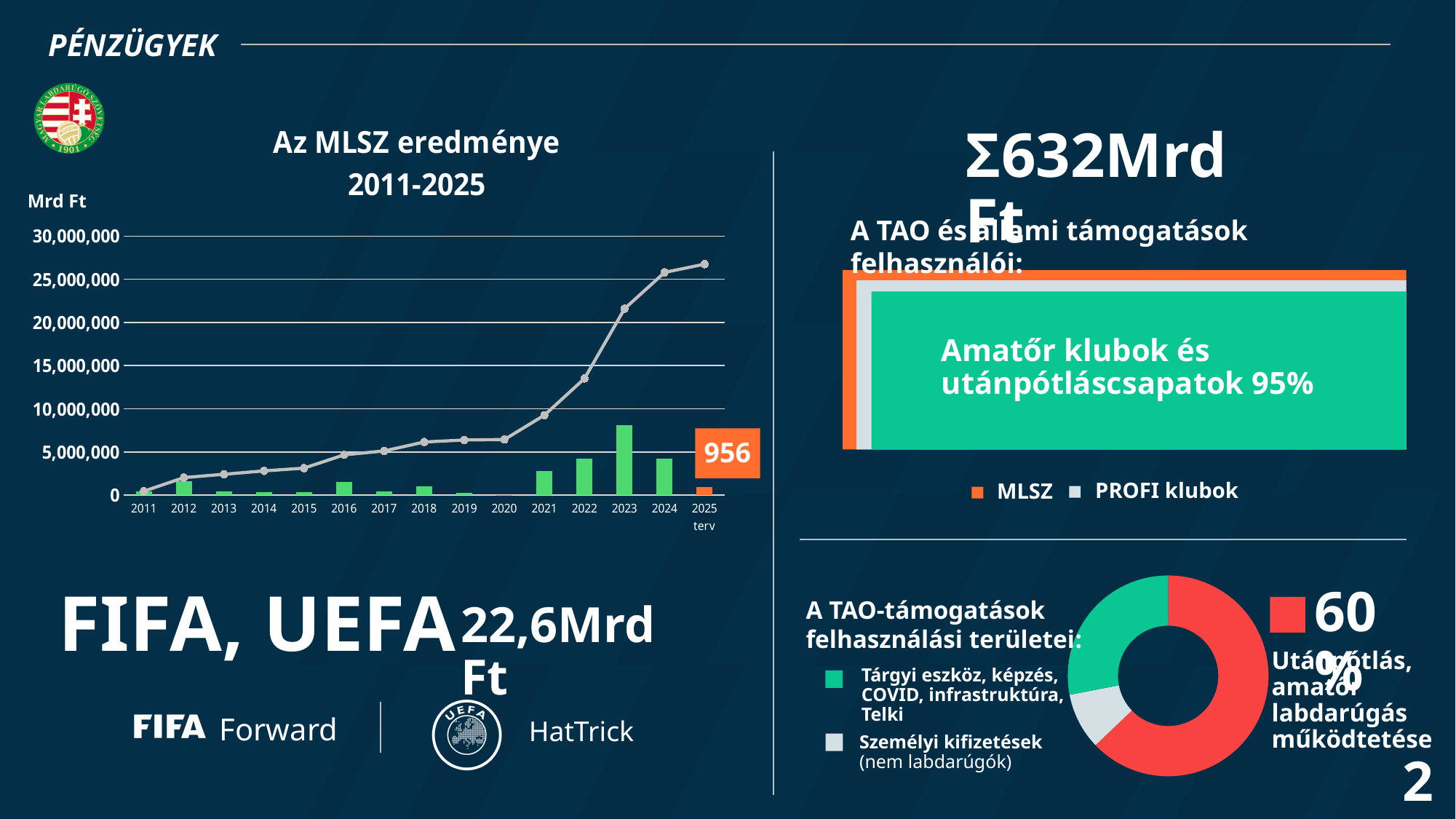
In the chart 'Az MLSZ eredménye 2011-2025', is the line value for 2022 greater or less than 10,000,000? greater In the chart 'A TAO és állami támogatások felhasználói', what percentage is shown for Amatőr klubok és utánpótláscsapatok? 95% In the chart 'Az MLSZ eredménye 2011-2025', which year has the tallest bar? 2023 In the chart 'Az MLSZ eredménye 2011-2025', which bar is taller, 2022 or 2023? 2023 In the chart 'Az MLSZ eredménye 2011-2025', does the grey line rise or fall from 2011 to 2025? It rises In the donut chart 'A TAO-támogatások felhasználási területei', what share is labelled for Utánpótlás, amatőr labdarúgás működtetése? 60% In the chart 'Az MLSZ eredménye 2011-2025', how many years are shown on the x axis? 15 In the chart 'Az MLSZ eredménye 2011-2025', is the line value for 2025 terv greater or less than 25,000,000? greater In the chart 'Az MLSZ eredménye 2011-2025', what value is labelled on the orange bar for 2025 terv? 956 In the donut chart 'A TAO-támogatások felhasználási területei', which category has the smallest slice? Személyi kifizetések (nem labdarúgók) In the chart 'Az MLSZ eredménye 2011-2025', is the bar for 2023 greater or less than 5,000,000? greater What kind of chart is 'Az MLSZ eredménye 2011-2025'? A combined bar and line chart